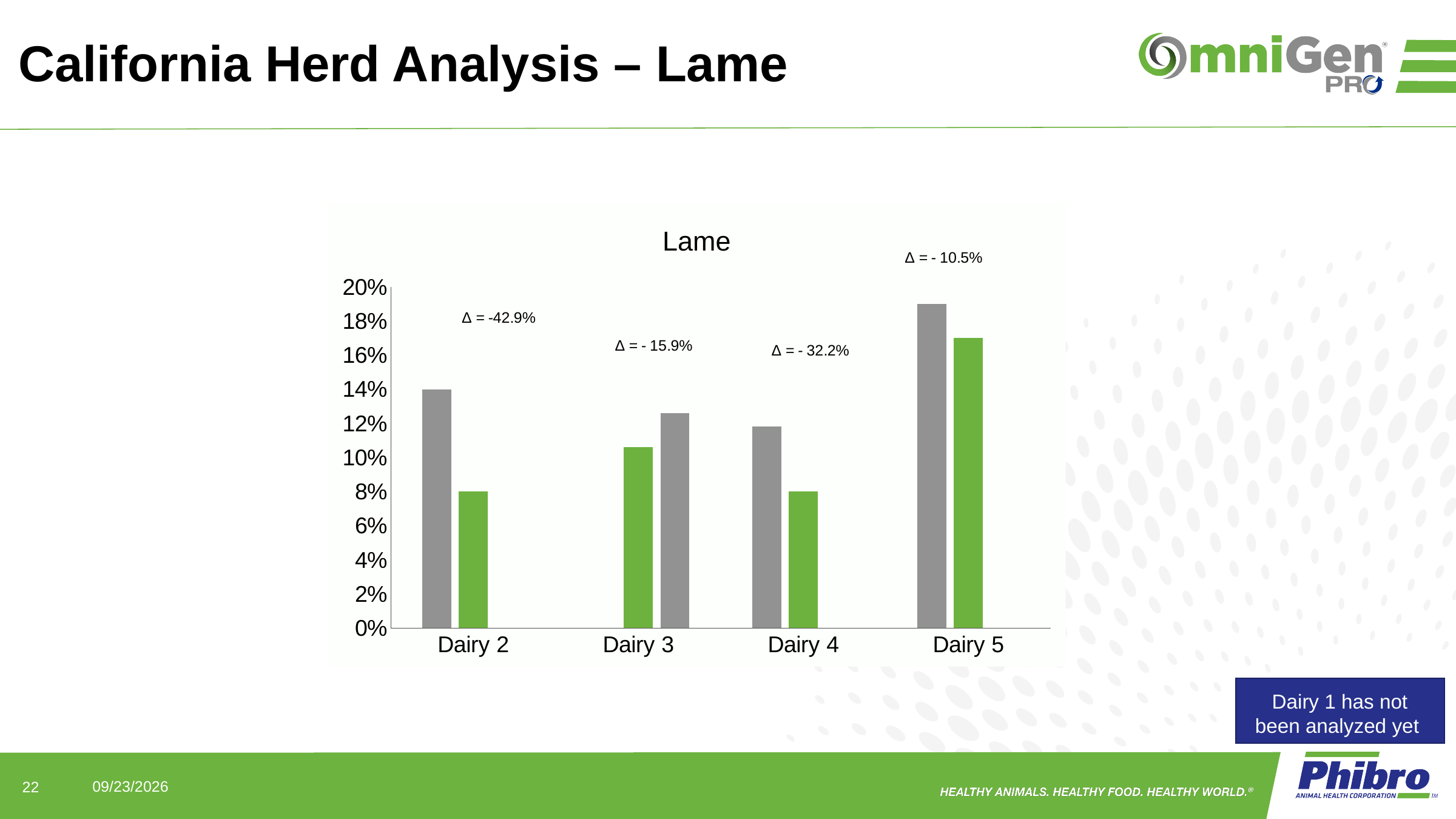
Is the green bar for Dairy 2 greater or less than 10%? less What delta value is printed above the bars for Dairy 2? Δ = -42.9% What delta value is printed above the bars for Dairy 4? Δ = - 32.2% What kind of chart is shown on the slide? bar chart How many dairies are shown on the x axis of the chart? 4 What is the title of the chart? Lame What delta value is printed above the bars for Dairy 3? Δ = - 15.9% Which dairy has the tallest green bar? Dairy 5 For Dairy 3, which bar is taller, the gray bar or the green bar? the gray bar Is the gray bar for Dairy 5 greater or less than 18%? greater Which dairy has the tallest gray bar? Dairy 5 What delta value is printed above the bars for Dairy 5? Δ = - 10.5%